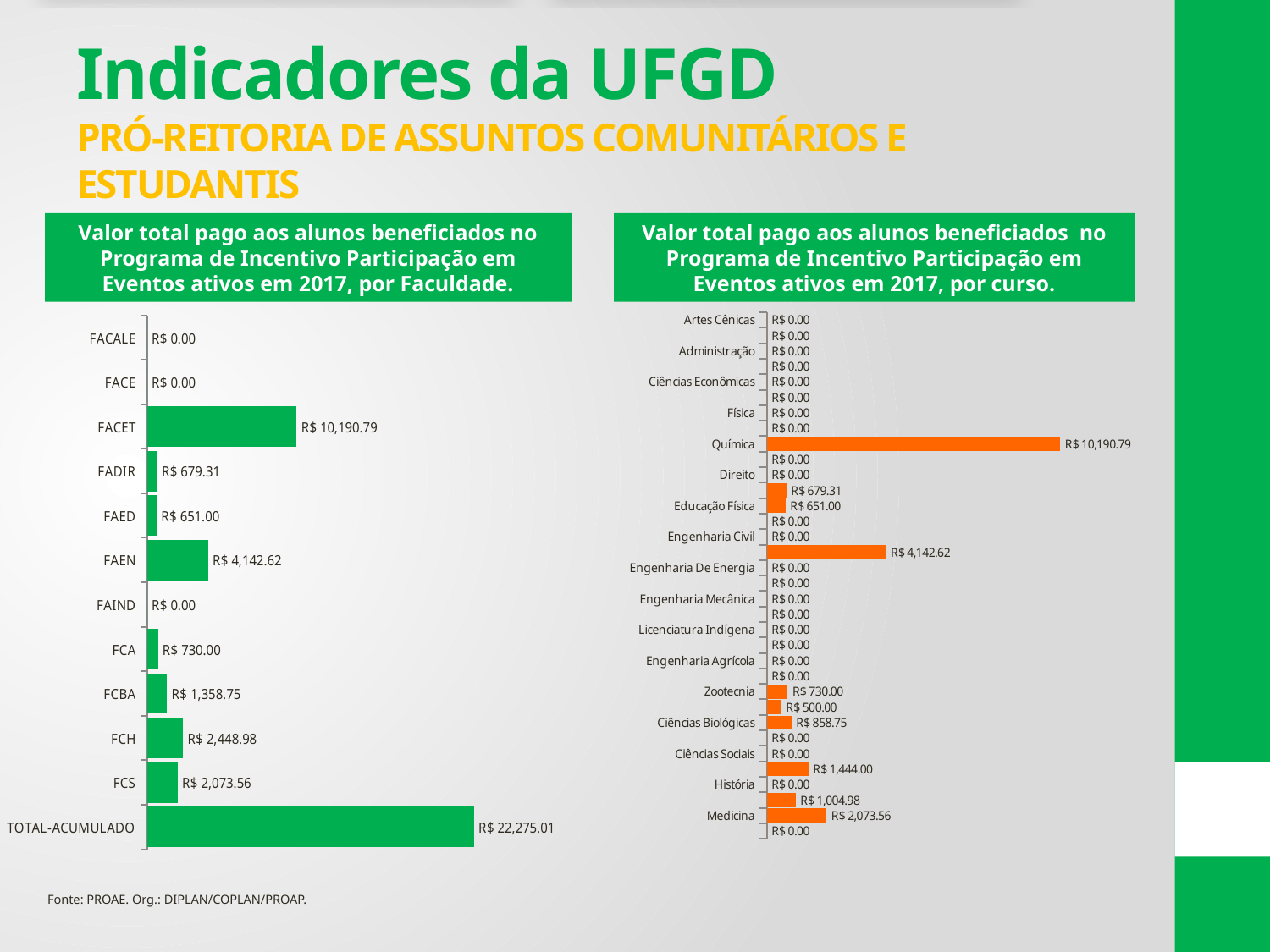
In the left chart (by Faculdade), which faculty (excluding TOTAL-ACUMULADO) has the highest value? FACET In the right chart (by curso), what is the value for Medicina? R$ 2,073.56 In the left chart (by Faculdade), what is the value for FAEN? R$ 4,142.62 In the left chart (by Faculdade), how many faculties show a value of R$ 0.00? 3 In the left chart (by Faculdade), what is the value shown for TOTAL-ACUMULADO? R$ 22,275.01 In the left chart (by Faculdade), which is larger, the value for FCBA or the value for FCA? FCBA What type of chart is the left chart (by Faculdade)? Bar chart In the left chart (by Faculdade), what is the value for FACET? R$ 10,190.79 In the right chart (by curso), what is the value for Química? R$ 10,190.79 In the left chart (by Faculdade), how many categories are plotted, including TOTAL-ACUMULADO? 12 In the right chart (by curso), which course has the highest value? Química In the left chart (by Faculdade), what is the difference between the values for FCH and FCS? R$ 375.42